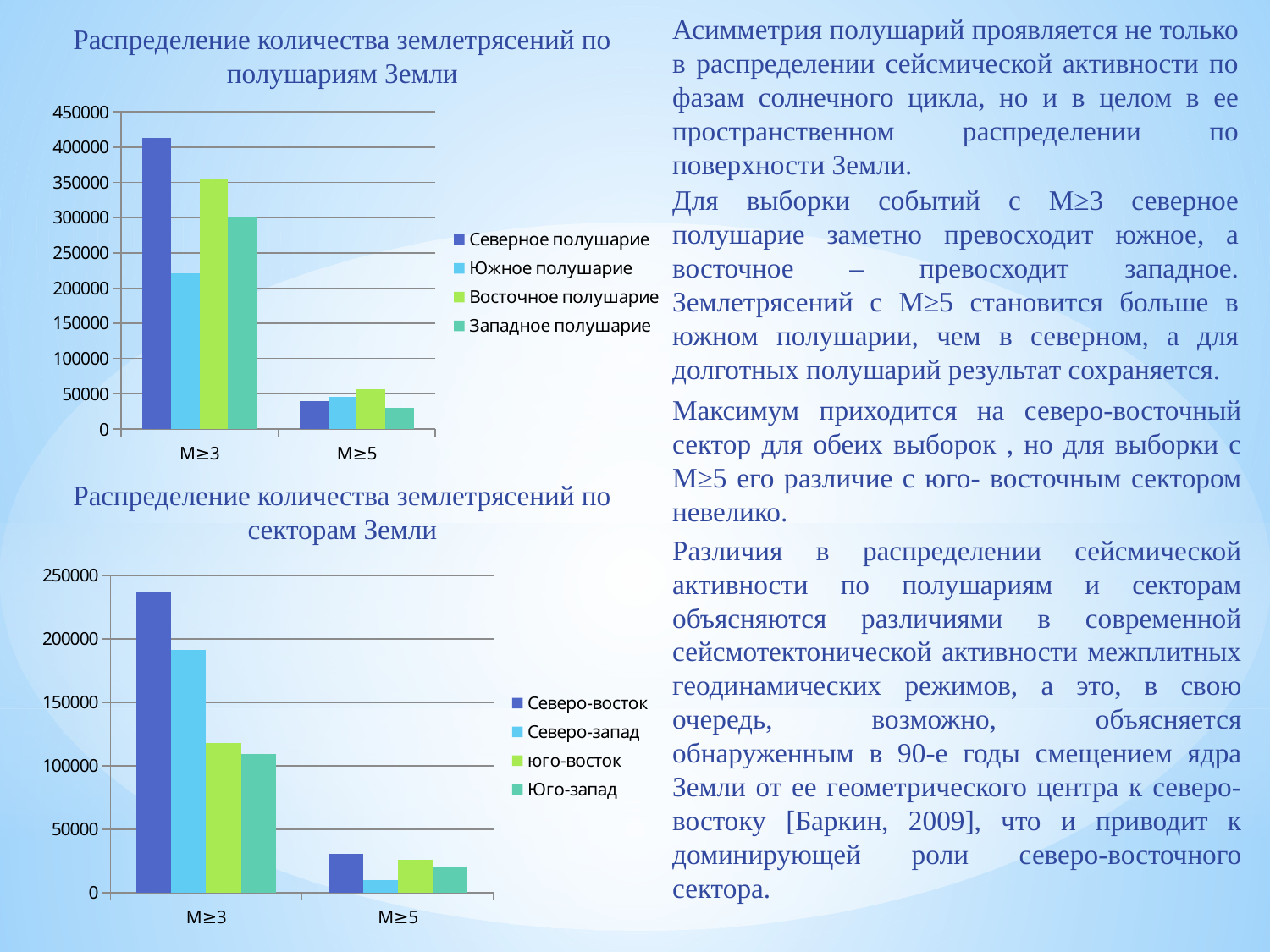
In the top chart ('по полушариям Земли'), how many categories are shown on the x axis? 2 In the top chart ('по полушариям Земли'), which hemisphere has the highest value for M≥3? Северное полушарие In the top chart ('по полушариям Земли'), is the value for Южное полушарие at M≥3 greater or less than 250000? less In the bottom chart ('по секторам Земли'), is the value for Северо-восток at M≥3 greater or less than 200000? greater In the bottom chart ('по секторам Земли'), which sector has the highest value for M≥3? Северо-восток In the top chart ('по полушариям Земли'), which hemisphere has the lowest value for M≥5? Западное полушарие In the top chart ('по полушариям Земли'), does the value for Северное полушарие rise or fall from M≥3 to M≥5? fall What kind of chart is the top chart, 'Распределение количества землетрясений по полушариям Земли'? bar chart In the top chart ('по полушариям Земли'), is the value for Северное полушарие at M≥3 greater or less than 400000? greater In the top chart ('по полушариям Земли'), how many series does the legend list? 4 In the bottom chart ('по секторам Земли'), which sector has the lowest value for M≥5? Северо-запад In the top chart ('по полушариям Земли'), which is larger for M≥3: Восточное полушарие or Западное полушарие? Восточное полушарие